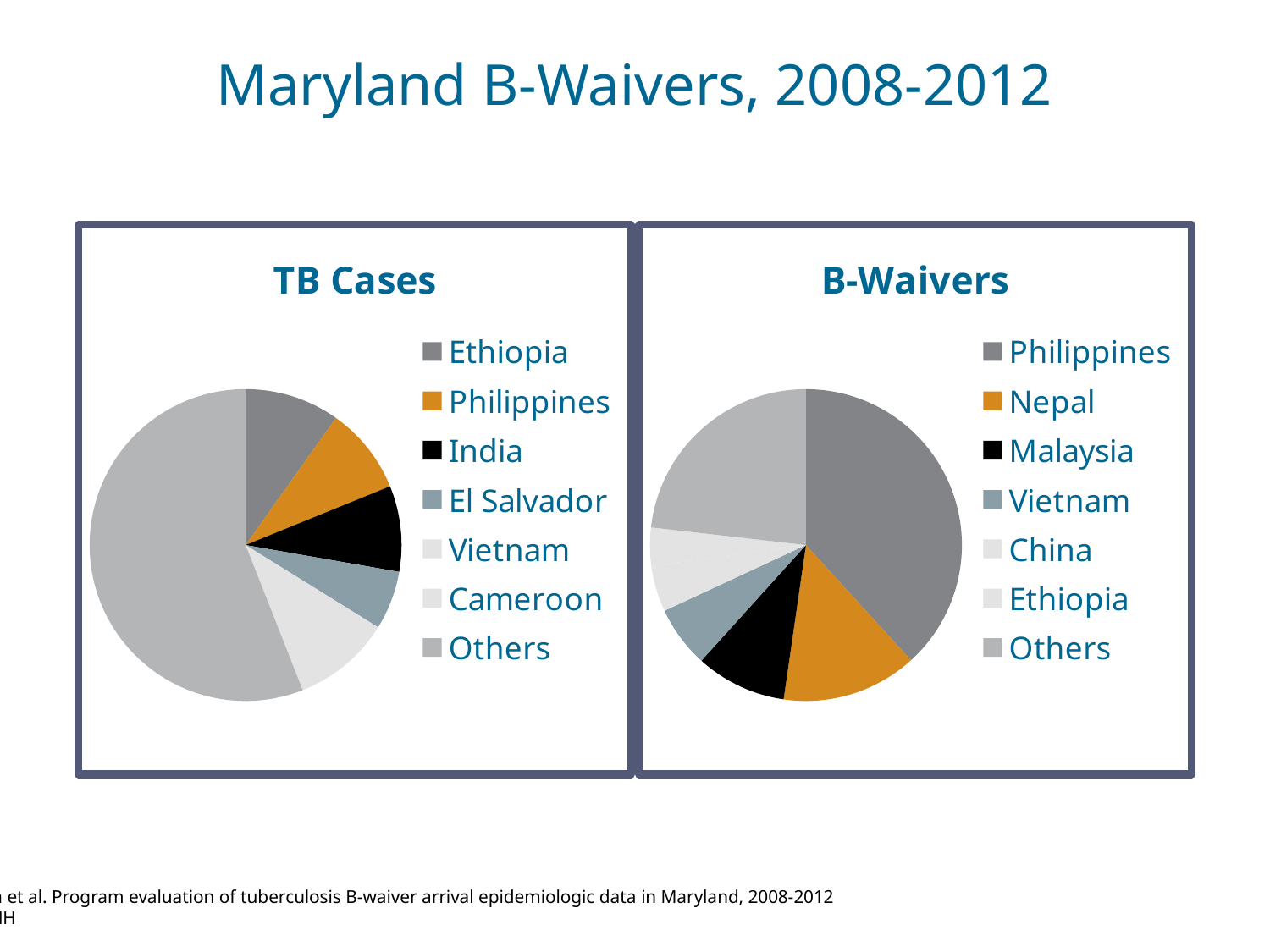
In the B-Waivers chart, which slice is larger, Philippines or Nepal? Philippines What kind of chart is the TB Cases chart? pie chart In the TB Cases chart, which category has the largest slice? Others What is the title of the chart on the right side of the slide? B-Waivers How many categories does the legend of the TB Cases chart list? 7 In the B-Waivers chart, which category has the largest slice? Philippines How many categories does the legend of the B-Waivers chart list? 7 In the TB Cases chart, which slice is larger, Others or Ethiopia? Others In the B-Waivers chart, which category is shown in orange? Nepal What kind of chart is the B-Waivers chart? pie chart In the B-Waivers chart, which slice is larger, Nepal or Vietnam? Nepal